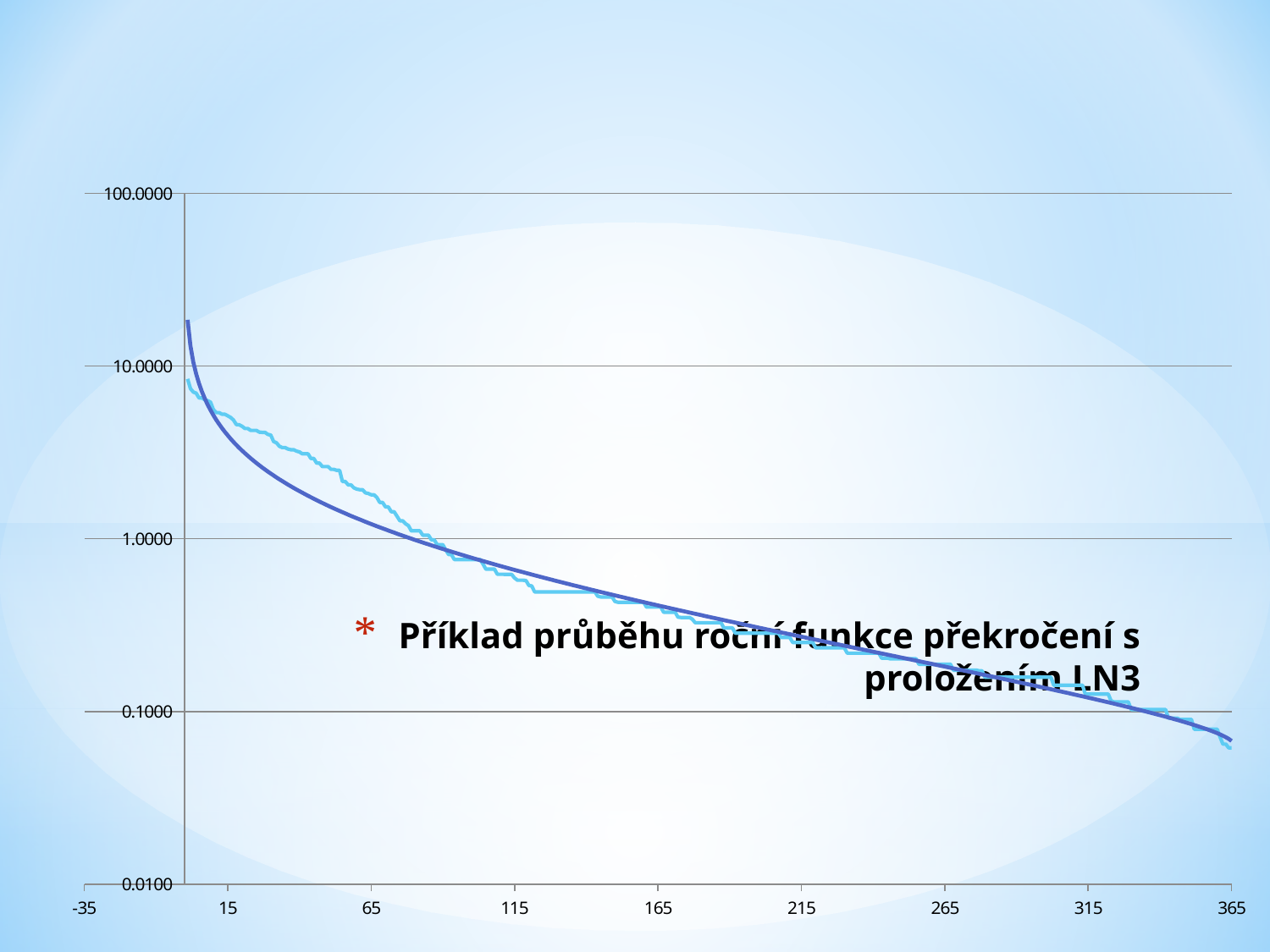
Is the value of the light blue line at x = 15 greater or less than 10.0000? less Is the value of the dark blue line at x = 215 greater or less than 1.0000? less What kind of chart is shown on the slide? line chart Do the plotted values rise or fall as the x-axis value increases? fall What is the rightmost value labelled on the x-axis? 365 At x = 65, which line has the higher value, the light blue line or the dark blue line? light blue line Is the value of the light blue line at x = 65 greater or less than 1.0000? greater What is the highest value labelled on the y-axis? 100.0000 How many lines are plotted on the chart? 2